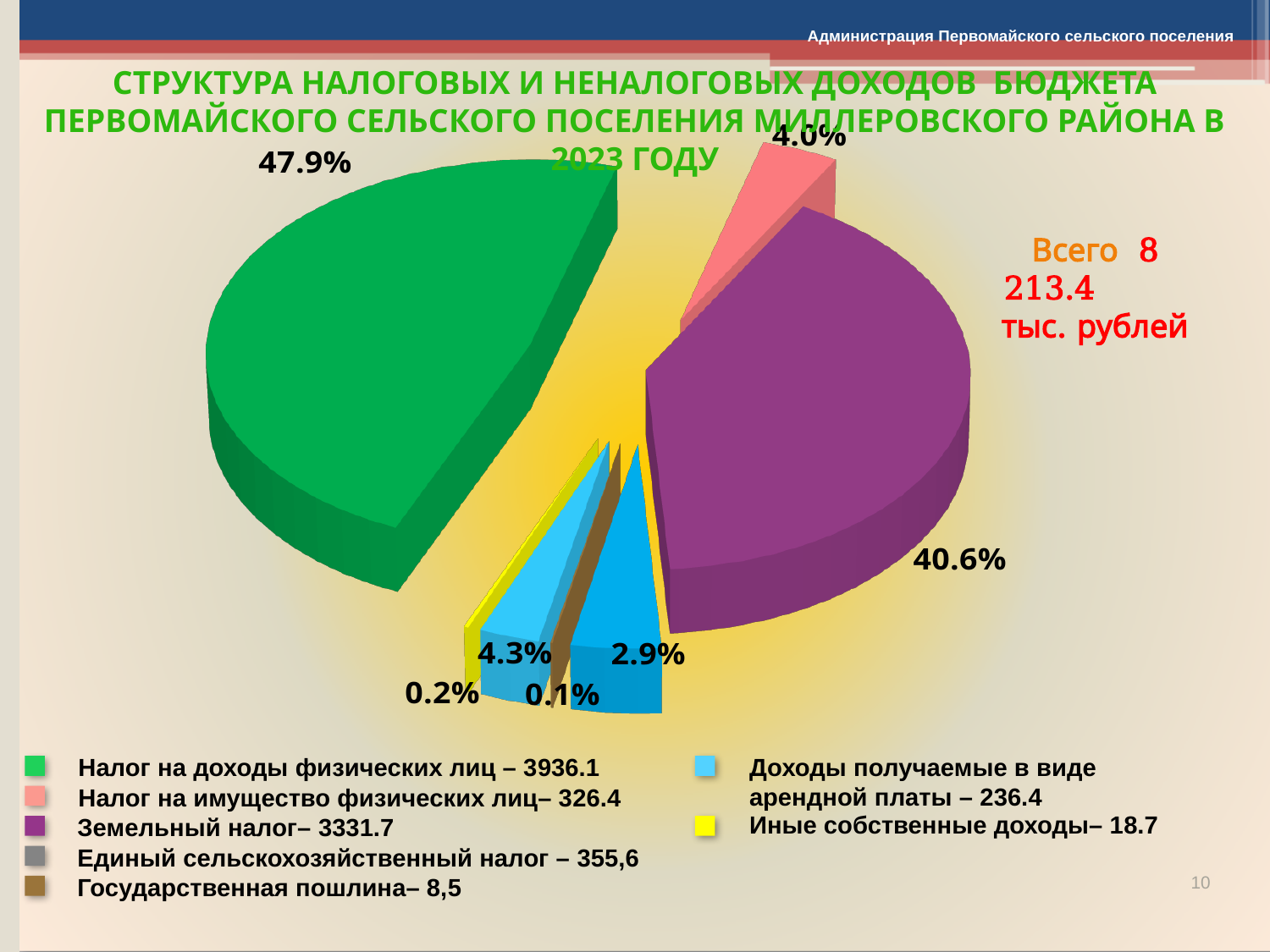
What value is given in the legend for Земельный налог? 3331.7 Which category has the largest slice of the pie? Налог на доходы физических лиц What share of the pie does Налог на доходы физических лиц take? 47.9% What is the difference between the legend values for Налог на доходы физических лиц and Земельный налог? 604.4 What kind of chart is shown on the slide? pie chart What value is given in the legend for Доходы получаемые в виде арендной платы? 236.4 What share of the pie does Земельный налог take? 40.6% What share of the pie does Налог на имущество физических лиц take? 4.0% Which is larger, Налог на доходы физических лиц or Земельный налог? Налог на доходы физических лиц What total amount is stated next to the pie chart? 8 213.4 тыс. рублей How many categories does the legend of the pie chart list? 7 Which category has the smallest slice of the pie? Государственная пошлина